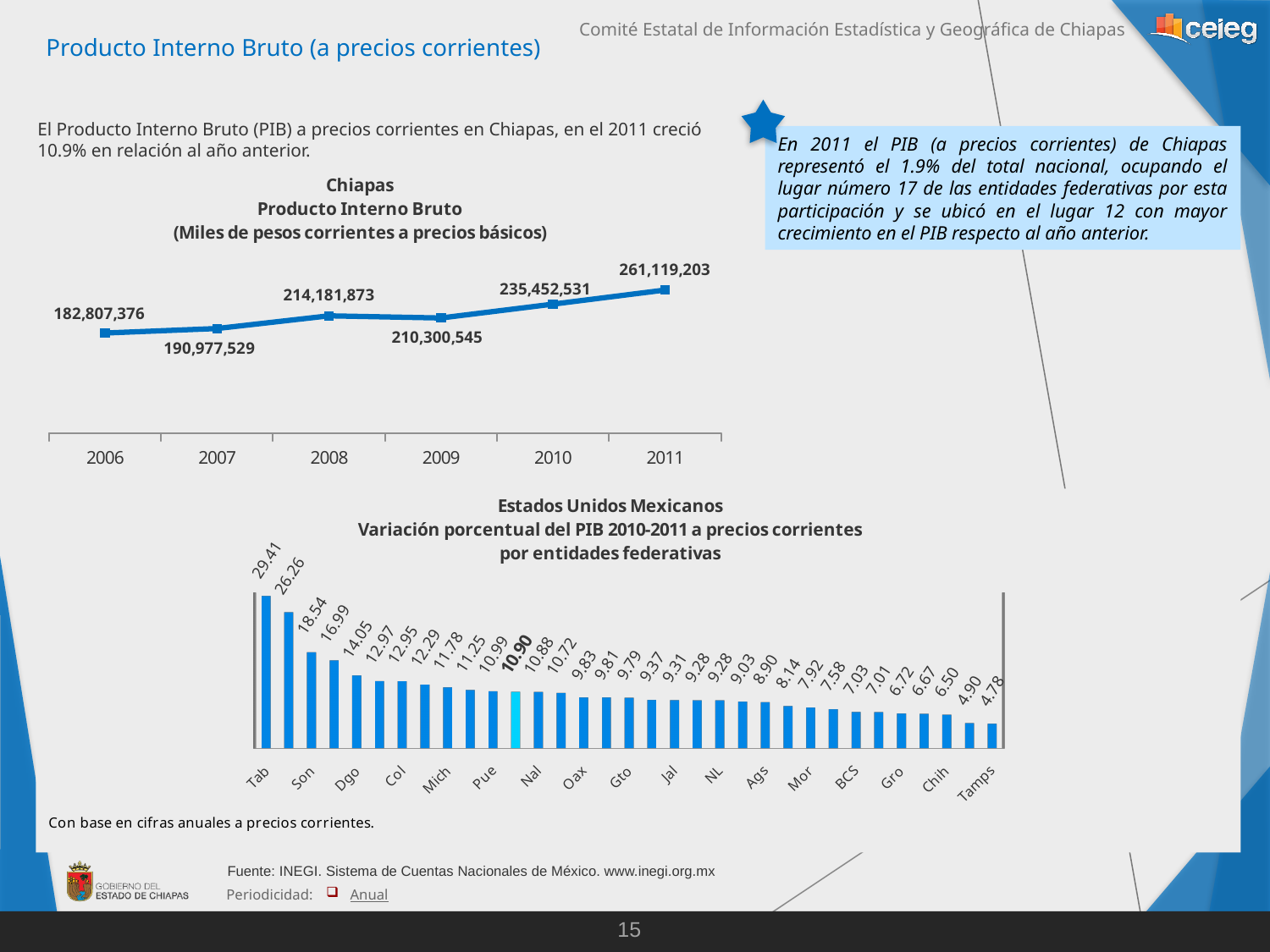
In the Chiapas Producto Interno Bruto chart, what is the value for 2011? 261,119,203 What kind of chart is the Chiapas Producto Interno Bruto chart? line chart In the Variación porcentual del PIB 2010-2011 chart, what is the value of the last bar, Tamps? 4.78 In the Variación porcentual del PIB 2010-2011 chart, what is the value for Tab, the first bar? 29.41 In the Chiapas Producto Interno Bruto chart, what is the value for 2009? 210,300,545 In the Chiapas Producto Interno Bruto chart, what is the value for 2006? 182,807,376 In the Chiapas Producto Interno Bruto chart, is the value for 2008 larger or smaller than the value for 2009? larger In the Chiapas Producto Interno Bruto chart, which year has the highest value? 2011 In the Chiapas Producto Interno Bruto chart, which year has the lowest value? 2006 In the Chiapas Producto Interno Bruto chart, what is the difference between the 2011 and 2010 values? 25,666,672 What kind of chart is the Variación porcentual del PIB 2010-2011 chart at the bottom of the slide? bar chart How many years are plotted in the Chiapas Producto Interno Bruto chart? 6